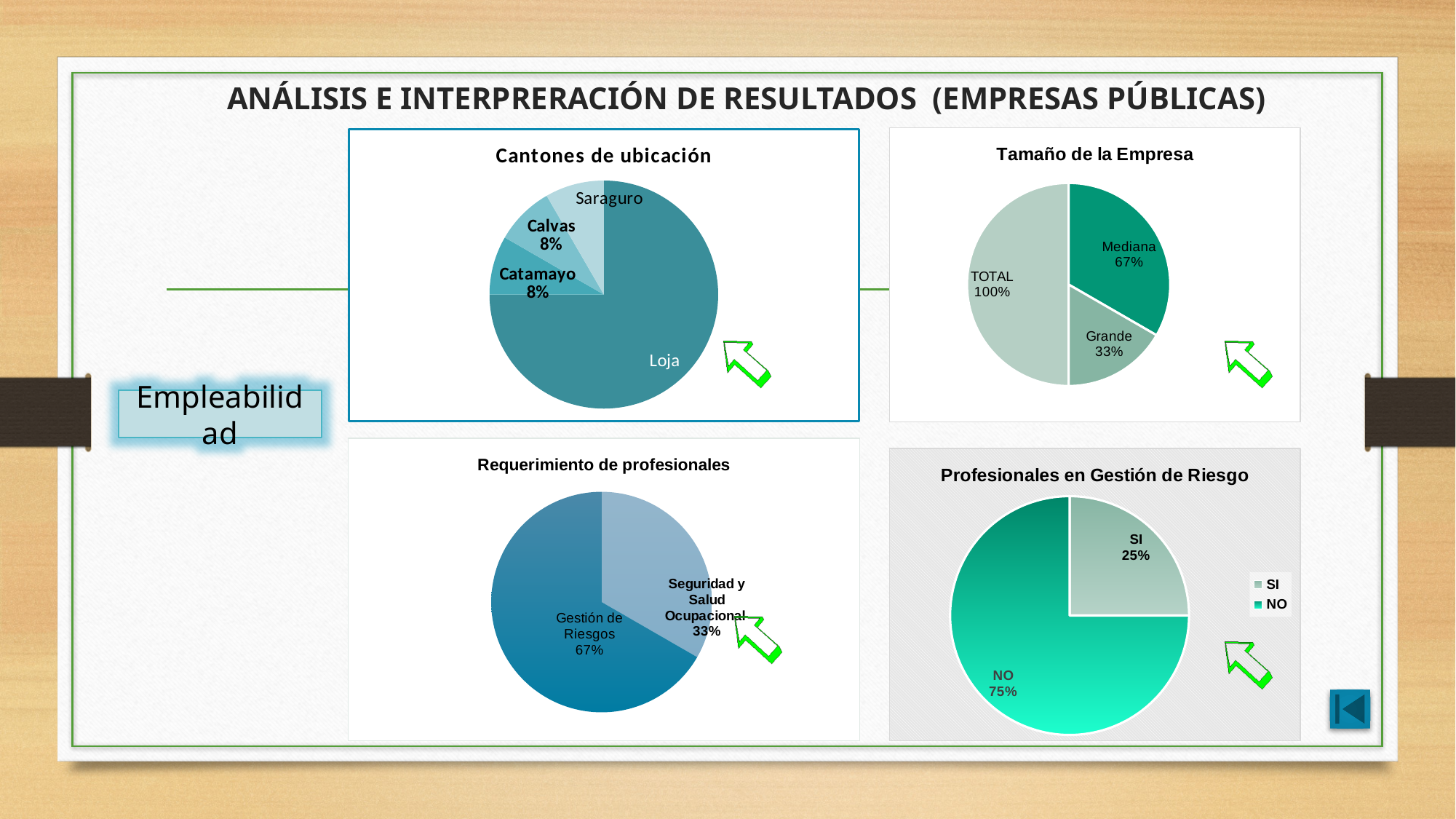
What kind of chart is 'Tamaño de la Empresa'? Pie chart In the 'Profesionales en Gestión de Riesgo' chart, what is the difference between the NO and SI percentages? 50 percentage points In the 'Tamaño de la Empresa' chart, what percentage is shown for Mediana? 67% In the 'Profesionales en Gestión de Riesgo' chart, what percentage is shown for NO? 75% In the 'Profesionales en Gestión de Riesgo' chart, which slice is the smallest? SI In the 'Requerimiento de profesionales' chart, what percentage is shown for Gestión de Riesgos? 67% How many slices does the 'Cantones de ubicación' pie chart have? 4 In the 'Cantones de ubicación' chart, what percentage is shown for Calvas? 8% In the 'Cantones de ubicación' chart, which canton has the largest slice? Loja In the 'Requerimiento de profesionales' chart, which is larger: Gestión de Riesgos or Seguridad y Salud Ocupacional? Gestión de Riesgos In the 'Tamaño de la Empresa' chart, what is the difference between the Mediana and Grande percentages? 34 percentage points How many entries does the legend of the 'Profesionales en Gestión de Riesgo' chart list? 2